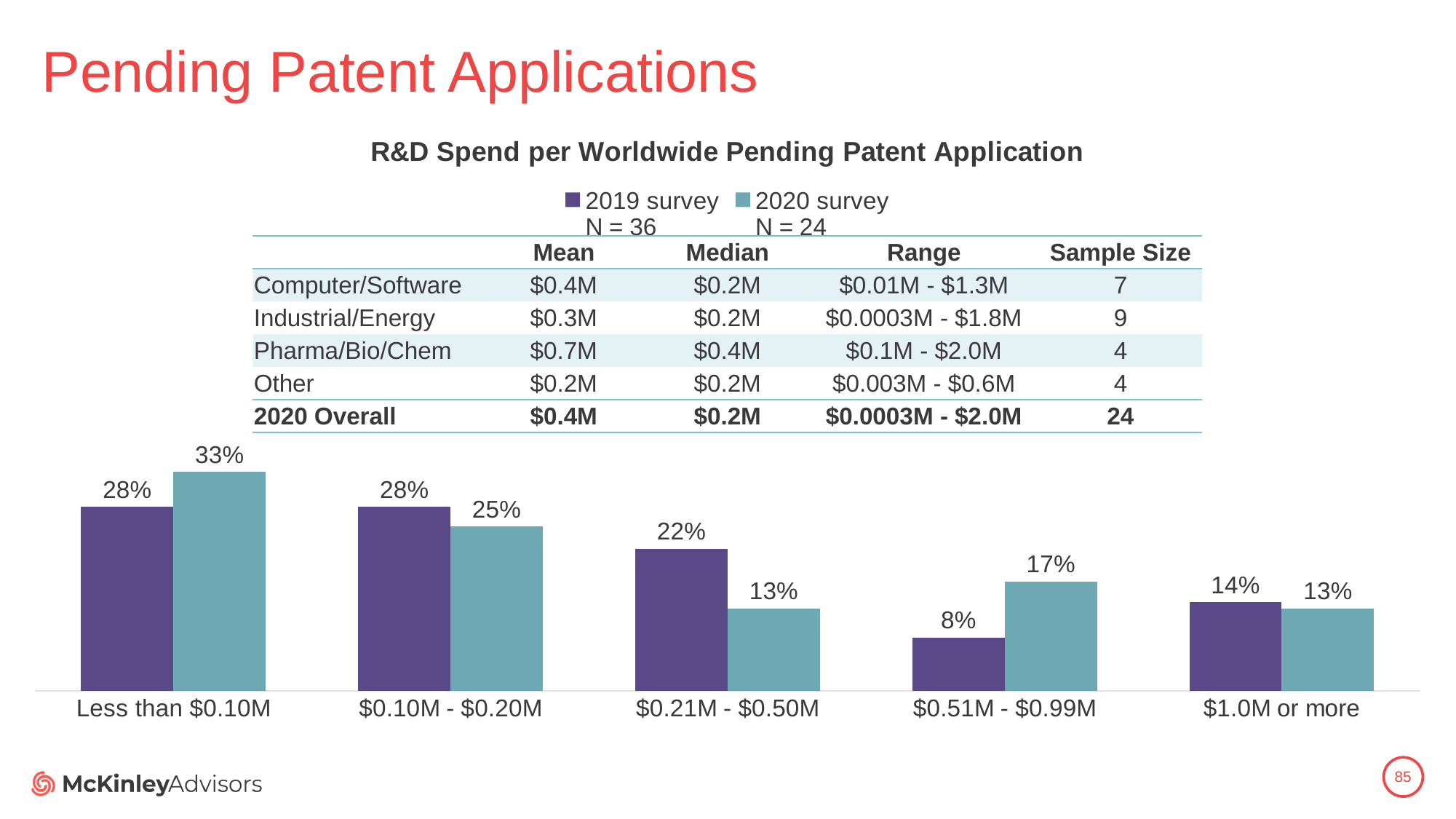
What is the 2020 survey value for the '$0.51M - $0.99M' category? 17% Which is larger for the '$0.10M - $0.20M' category: the 2019 survey value or the 2020 survey value? 2019 survey What kind of chart is shown on the slide? Bar chart Which category has the highest 2020 survey value? Less than $0.10M How many categories are shown on the x axis of the chart? 5 What is the 2020 survey value for the '$0.21M - $0.50M' category? 13% Do the 2019 survey values generally rise or fall from 'Less than $0.10M' to '$0.51M - $0.99M'? Fall What is the difference between the 2019 survey and 2020 survey values for the '$0.21M - $0.50M' category? 9% What is the title of the chart? R&D Spend per Worldwide Pending Patent Application What is the 2019 survey value for the 'Less than $0.10M' category? 28% Which category has the lowest 2019 survey value? $0.51M - $0.99M How many series does the chart legend list? 2